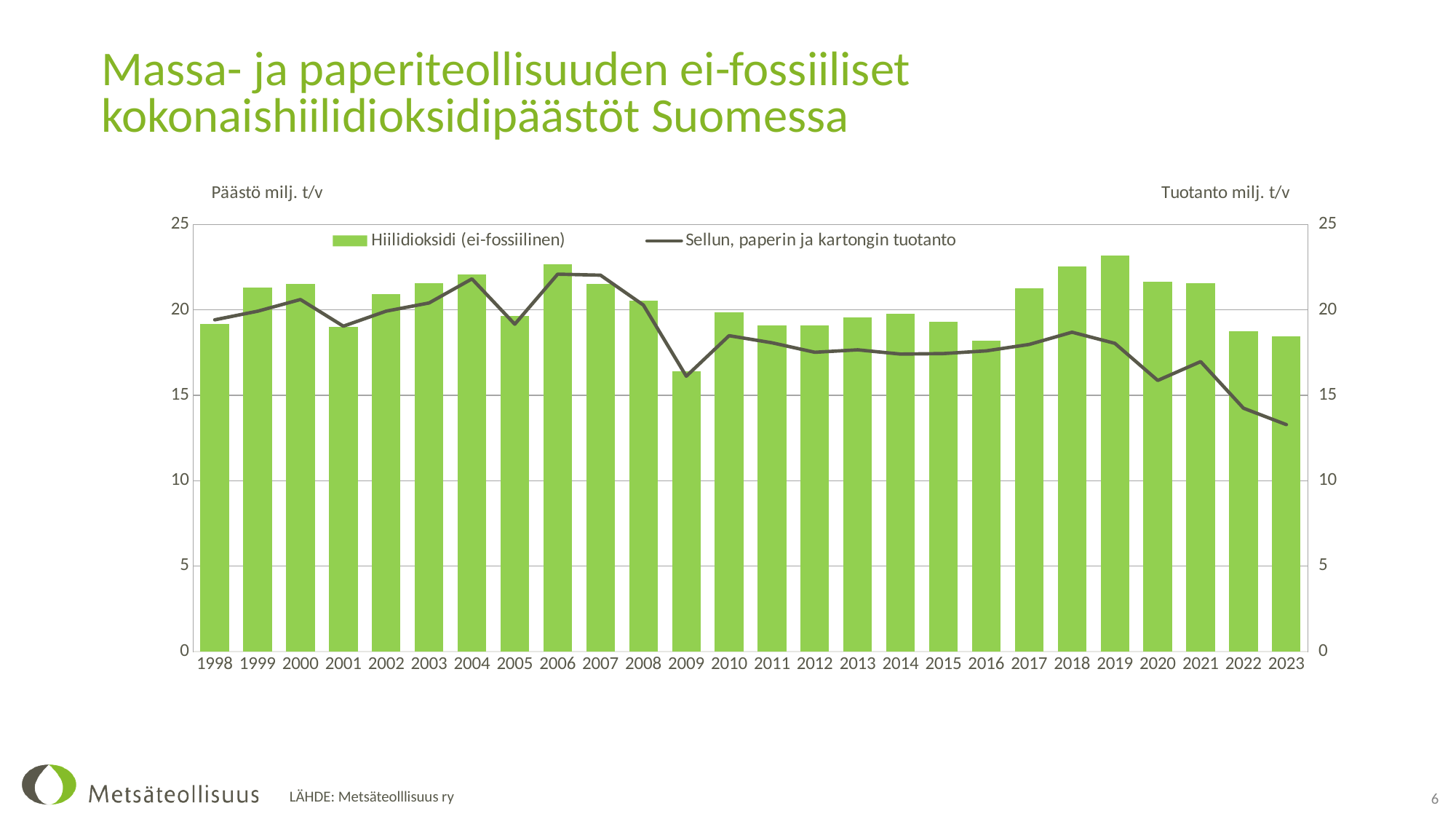
How many series does the legend list? 2 Which year has the larger Hiilidioksidi (ei-fossiilinen) bar, 2018 or 2022? 2018 Which year has the shortest bar for Hiilidioksidi (ei-fossiilinen)? 2009 What is the label of the left vertical axis? Päästö milj. t/v In which year is the Sellun, paperin ja kartongin tuotanto line at its lowest? 2023 Is the Hiilidioksidi (ei-fossiilinen) value for 2019 greater or less than 20? greater Which year has the tallest bar for Hiilidioksidi (ei-fossiilinen)? 2019 Is the Hiilidioksidi (ei-fossiilinen) value for 2009 greater or less than 20? less Does the Sellun, paperin ja kartongin tuotanto line rise or fall from 2019 to 2023? fall Is the Sellun, paperin ja kartongin tuotanto value for 2023 greater or less than 15? less How many years are shown on the x axis? 26 What kind of chart is shown on the slide? A bar chart combined with a line